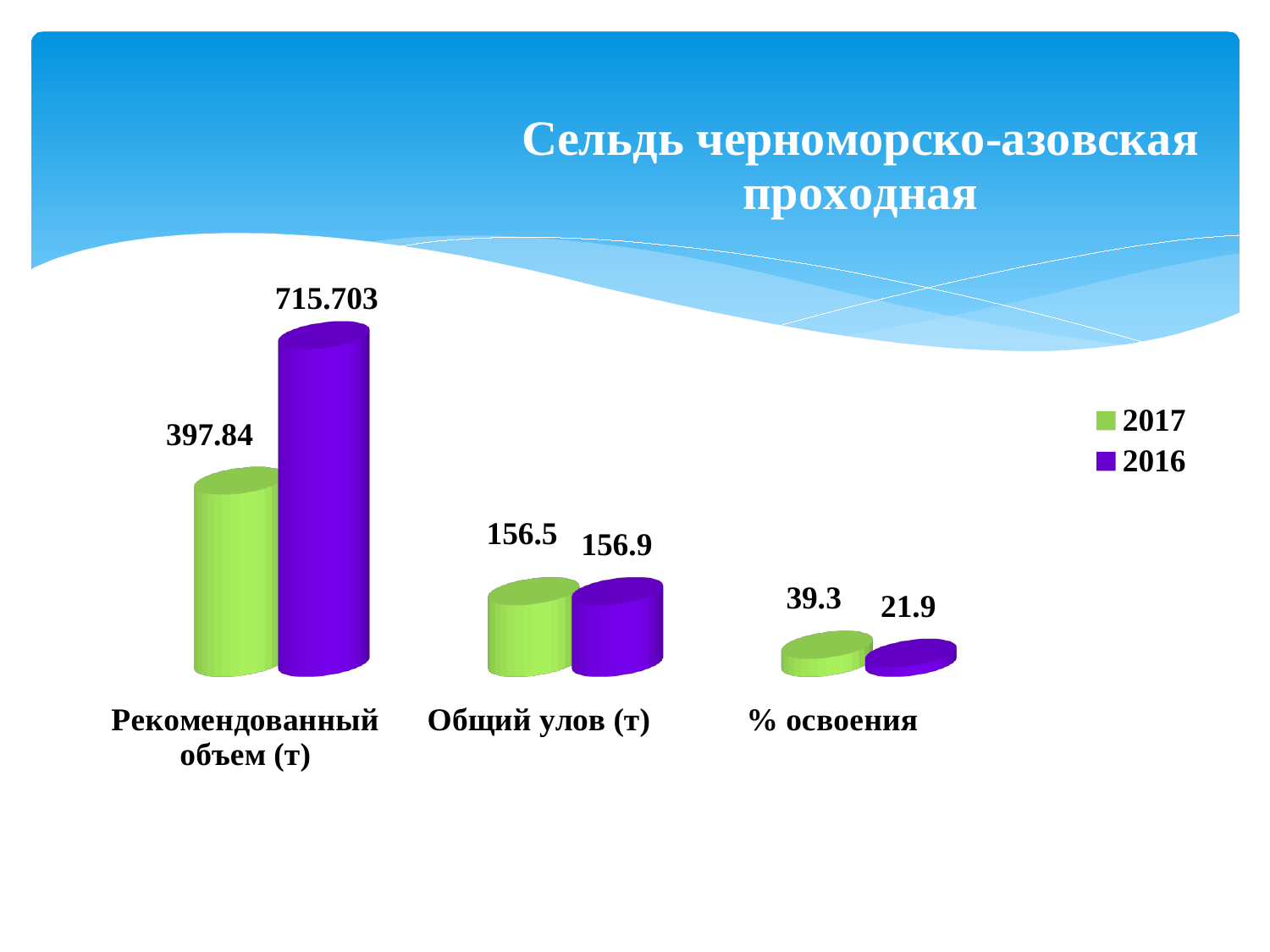
Which category has the highest value for the 2016 series? Рекомендованный объем (т) What is the value for 2017 in the Рекомендованный объем (т) category? 397.84 What is the difference between the 2017 and 2016 values in the % освоения category? 17.4 What is the value for 2016 in the Рекомендованный объем (т) category? 715.703 What is the value for 2016 in the % освоения category? 21.9 How many series does the legend list? 2 What is the difference between the 2016 and 2017 values in the Рекомендованный объем (т) category? 317.863 What is the value for 2017 in the Общий улов (т) category? 156.5 How many categories are shown on the x axis of the chart? 3 Which category has the lowest value for the 2017 series? % освоения In the % освоения category, which series has the larger value, 2017 or 2016? 2017 What kind of chart is shown on the slide? Bar chart